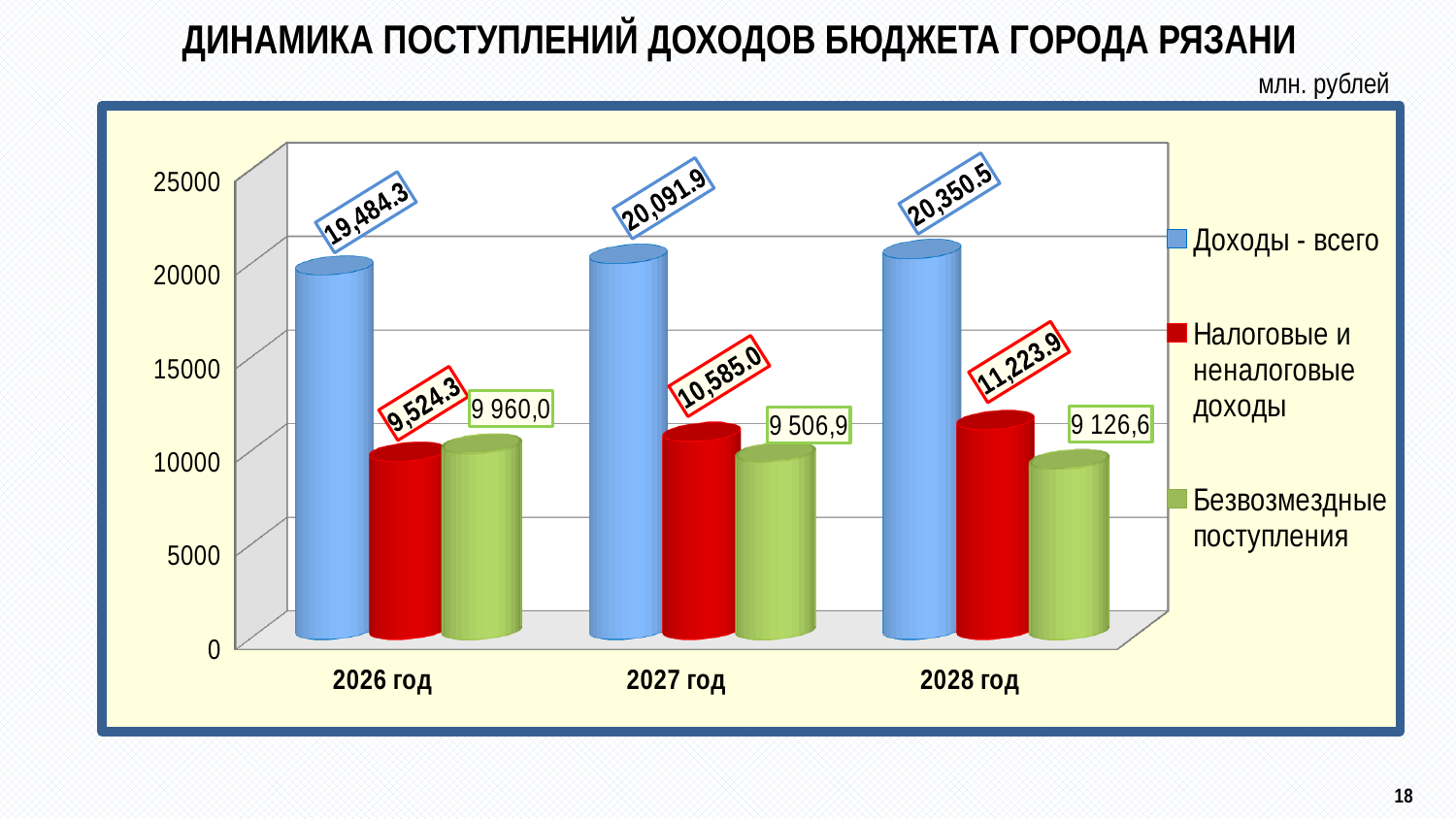
How many series does the legend list? 3 What unit of measurement is indicated above the chart? млн. рублей Do the values of "Безвозмездные поступления" rise or fall from 2026 год to 2028 год? Fall What is the value of "Налоговые и неналоговые доходы" for 2028 год? 11,223.9 In which year is "Безвозмездные поступления" the lowest? 2028 год What type of chart is shown on the slide? Bar chart What is the difference between "Доходы - всего" in 2028 год and in 2026 год? 866.2 What is the difference between "Налоговые и неналоговые доходы" in 2028 год and in 2026 год? 1,699.6 What is the value of "Доходы - всего" for 2026 год? 19,484.3 In 2026 год, which is larger: "Налоговые и неналоговые доходы" or "Безвозмездные поступления"? Безвозмездные поступления In which year is "Доходы - всего" the highest? 2028 год What is the value of "Безвозмездные поступления" for 2027 год? 9 506,9